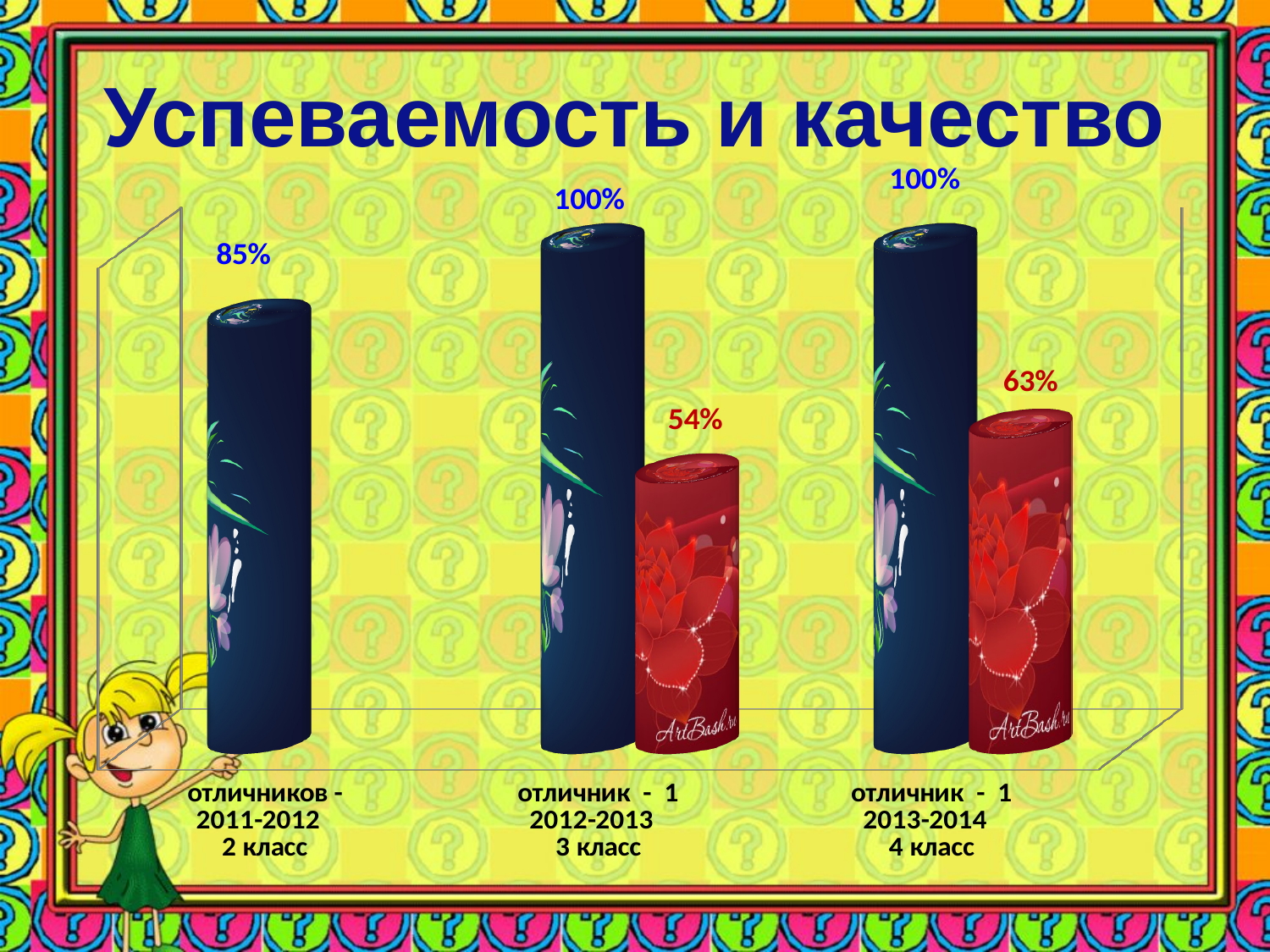
What is the title of the chart? Успеваемость и качество What is the value of the dark blue bar for 2012-2013 3 класс? 100% What kind of chart is shown on the slide? bar chart What is the value of the red bar for 2012-2013 3 класс? 54% Which has the larger red bar: 2012-2013 3 класс or 2013-2014 4 класс? 2013-2014 4 класс Which category has the lowest dark blue bar? 2011-2012 2 класс What is the value of the red bar for 2013-2014 4 класс? 63% What is the value of the dark blue bar for 2011-2012 2 класс? 85% How many categories are shown on the x axis? 3 By how much does the red bar for 2013-2014 4 класс exceed the red bar for 2012-2013 3 класс? 9% What is the difference between the dark blue bar and the red bar for 2013-2014 4 класс? 37% What is the difference between the dark blue bars for 2012-2013 3 класс and 2011-2012 2 класс? 15%